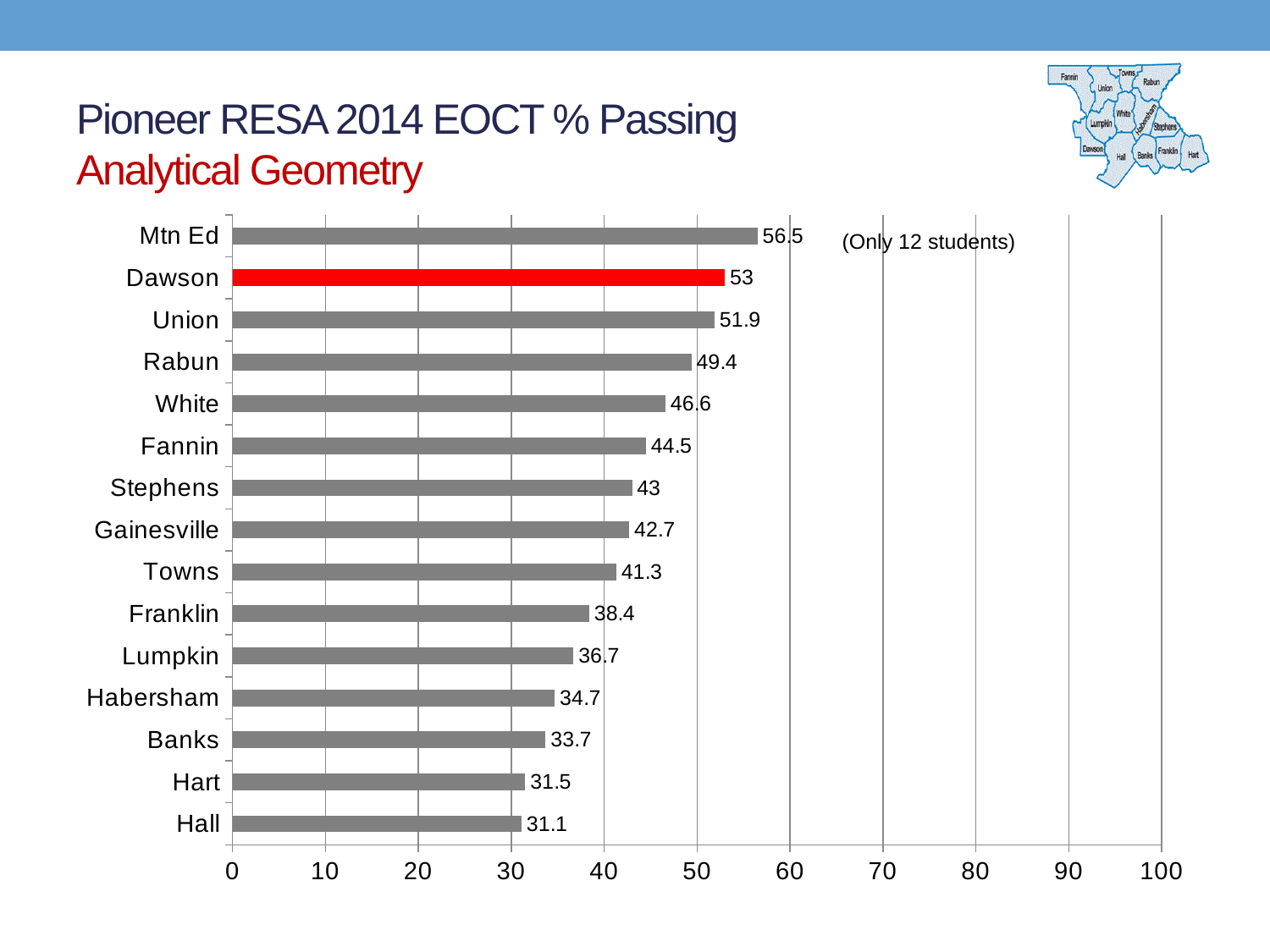
Which is larger, the value for Rabun or the value for White? Rabun Which bar is highlighted in red? Dawson What is the value for Hall? 31.1 Which category has the lowest value? Hall How many categories are shown in the chart? 15 What kind of chart is shown on the slide? bar chart Which category has the highest value? Mtn Ed What is the value for Dawson? 53 What is the difference between the values for Union and Hall? 20.8 What is the value for Gainesville? 42.7 Is the value for Franklin greater or less than 40? less What is the difference between the values for Mtn Ed and Dawson? 3.5